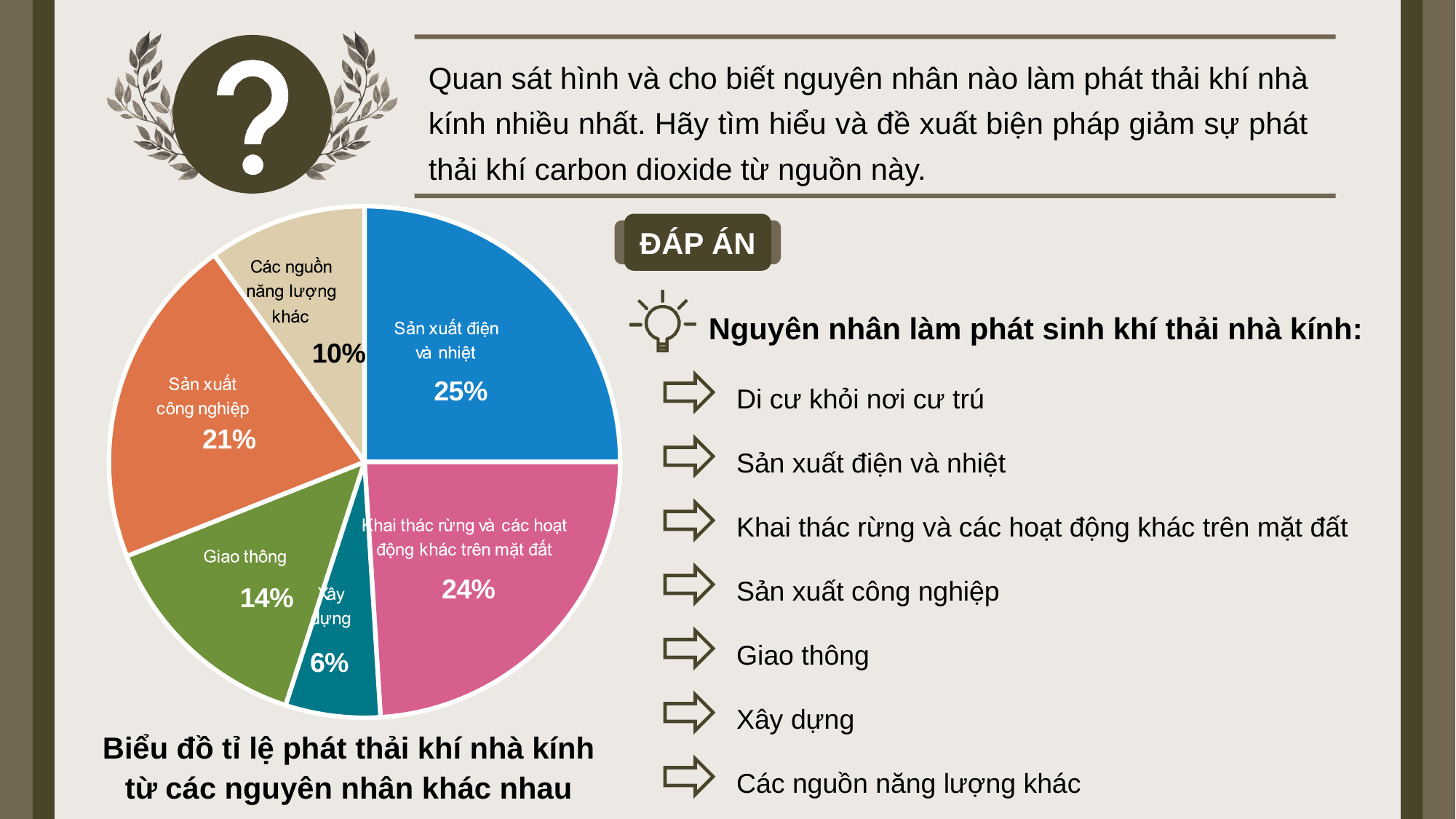
Which category has the largest share of the pie? Sản xuất điện và nhiệt What type of chart is shown on the slide? pie chart What is the difference in percentage points between "Sản xuất công nghiệp" and "Giao thông"? 7% What is the combined share of "Sản xuất điện và nhiệt" and "Khai thác rừng và các hoạt động khác trên mặt đất"? 49% Which category has the smallest share of the pie? Xây dựng What percentage is shown for "Giao thông"? 14% What percentage is shown for "Sản xuất công nghiệp"? 21% Which is larger, the share for "Khai thác rừng và các hoạt động khác trên mặt đất" or the share for "Các nguồn năng lượng khác"? Khai thác rừng và các hoạt động khác trên mặt đất What percentage is shown for "Xây dựng"? 6% What is the title of the pie chart? Biểu đồ tỉ lệ phát thải khí nhà kính từ các nguyên nhân khác nhau What percentage of greenhouse gas emissions comes from "Sản xuất điện và nhiệt"? 25% How many slices does the pie chart have? 6